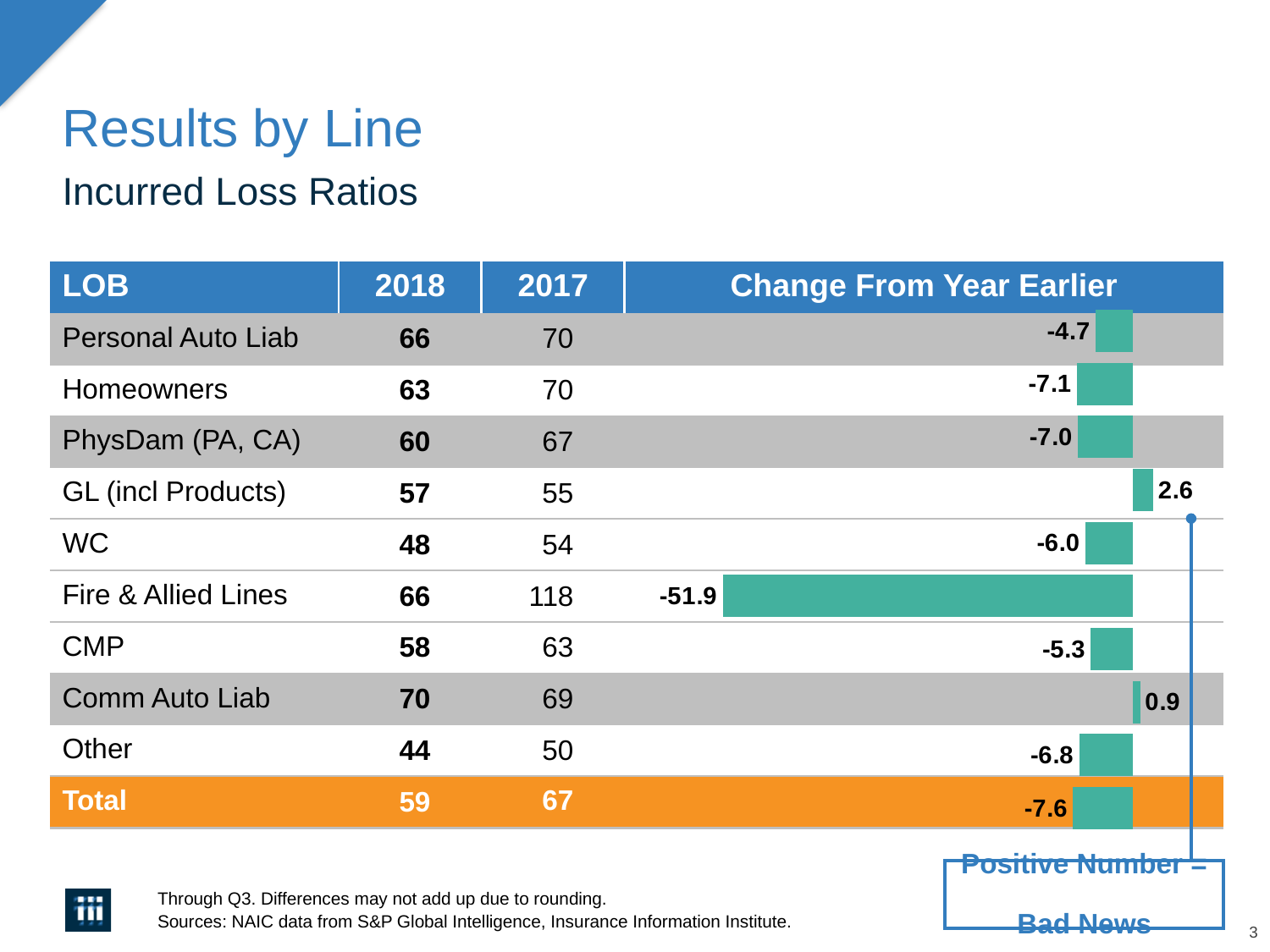
Which has a larger (less negative) Change From Year Earlier value, WC or Other? WC Which line of business has the largest negative Change From Year Earlier? Fire & Allied Lines What is the Change From Year Earlier value shown for Fire & Allied Lines? -51.9 Which line of business has the highest (most positive) Change From Year Earlier? GL (incl Products) What kind of chart is used in the Change From Year Earlier column? Bar chart What is the Change From Year Earlier value shown for the Total row? -7.6 How many rows, including Total, have a Change From Year Earlier bar plotted? 10 What is the title of the column containing the bars? Change From Year Earlier What is the difference between the Change From Year Earlier values for Homeowners (-7.1) and Personal Auto Liab (-4.7)? 2.4 What is the Change From Year Earlier value shown for GL (incl Products)? 2.6 Which has a larger Change From Year Earlier value, GL (incl Products) or Comm Auto Liab? GL (incl Products) What is the Change From Year Earlier value shown for Comm Auto Liab? 0.9